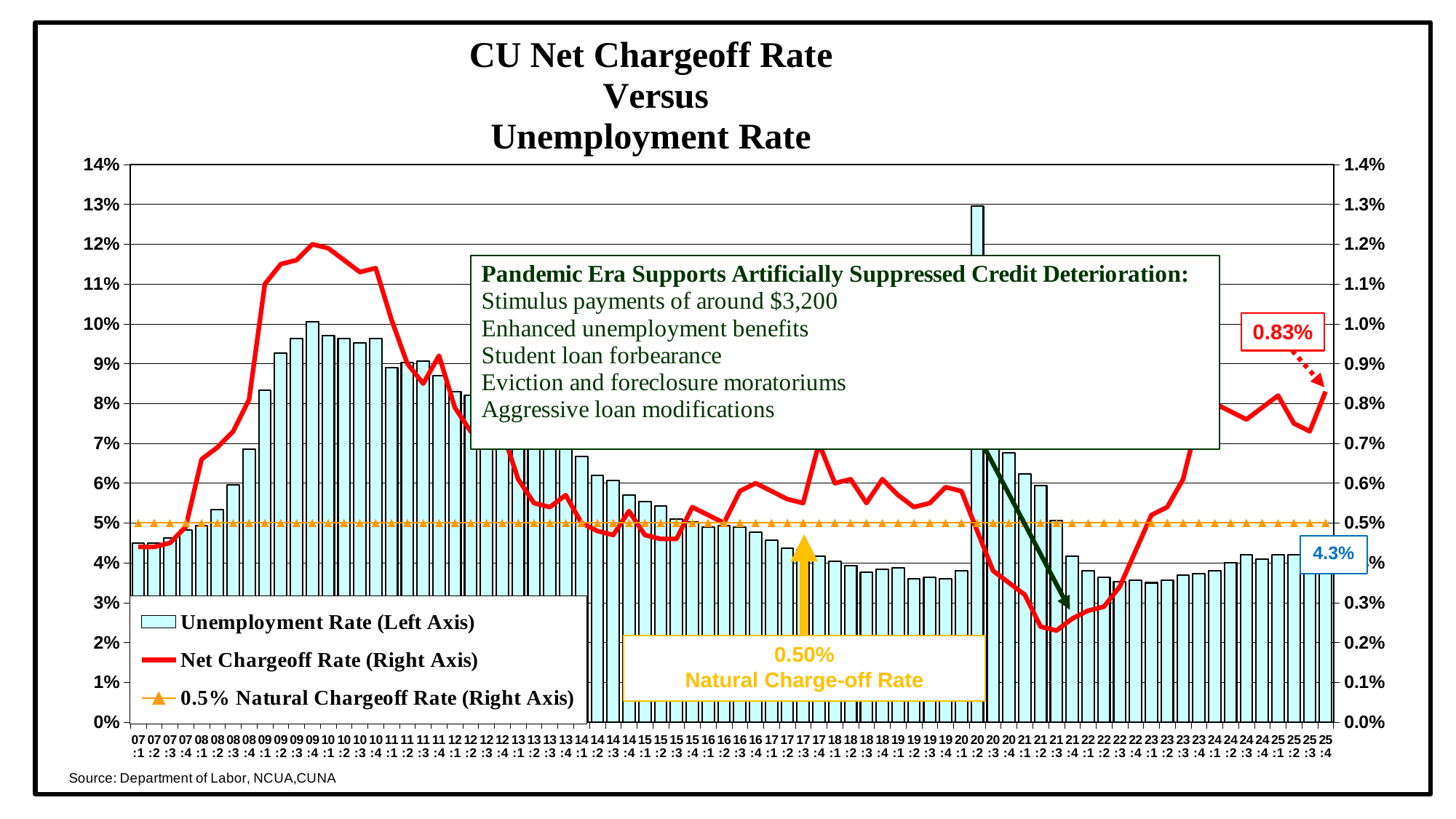
Is the Unemployment Rate for 20:2 greater or less than 12%? greater What is the Net Chargeoff Rate labelled at the end of the series (25:4)? 0.83% Which series is plotted on the left axis? Unemployment Rate What kind of chart is this? Combination bar and line chart Is the Net Chargeoff Rate for 21:2 greater or less than 0.3%? less Which is larger, the Net Chargeoff Rate in 09:4 or in 25:4? 09:4 How many series does the legend list? 3 What is the title of the chart? CU Net Chargeoff Rate Versus Unemployment Rate What is the Unemployment Rate labelled at the end of the series (25:4)? 4.3% Does the Net Chargeoff Rate rise or fall from 21:2 to 23:4? rise What value is the Natural Charge-off Rate line set at? 0.50% Which quarter has the highest Unemployment Rate? 20:2